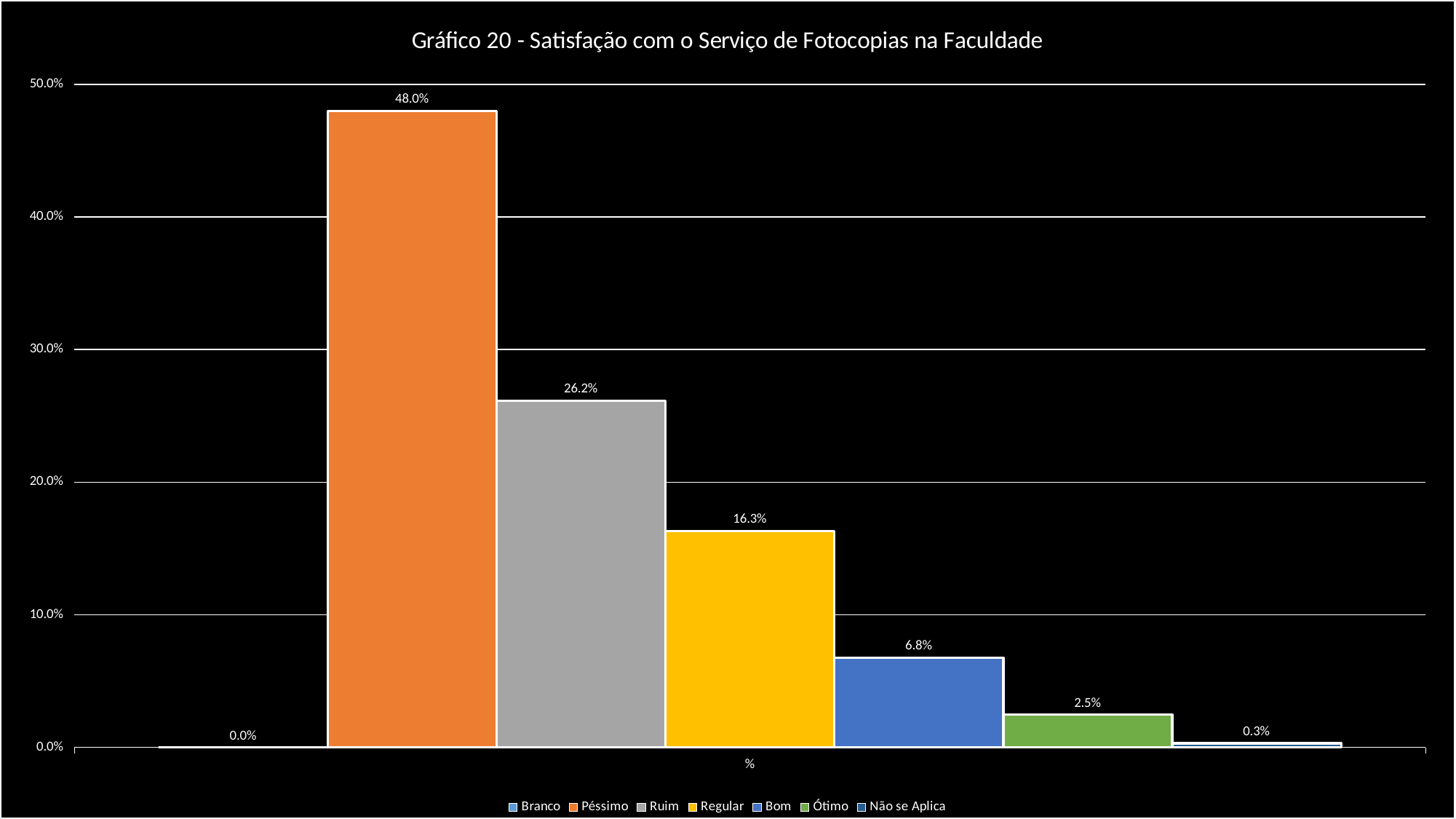
What is the value for Não se Aplica? 0.3% Which series has the lowest value? Branco What is the value for Ruim? 26.2% What is the value for Ótimo? 2.5% What is the value for Regular? 16.3% What is the value for Bom? 6.8% Which is larger, the value for Regular or the value for Bom? Regular What is the value for Péssimo? 48.0% Which series has the highest value? Péssimo How many series does the legend list? 7 What kind of chart is shown? Bar chart What is the difference between the values for Péssimo and Ruim? 21.8%